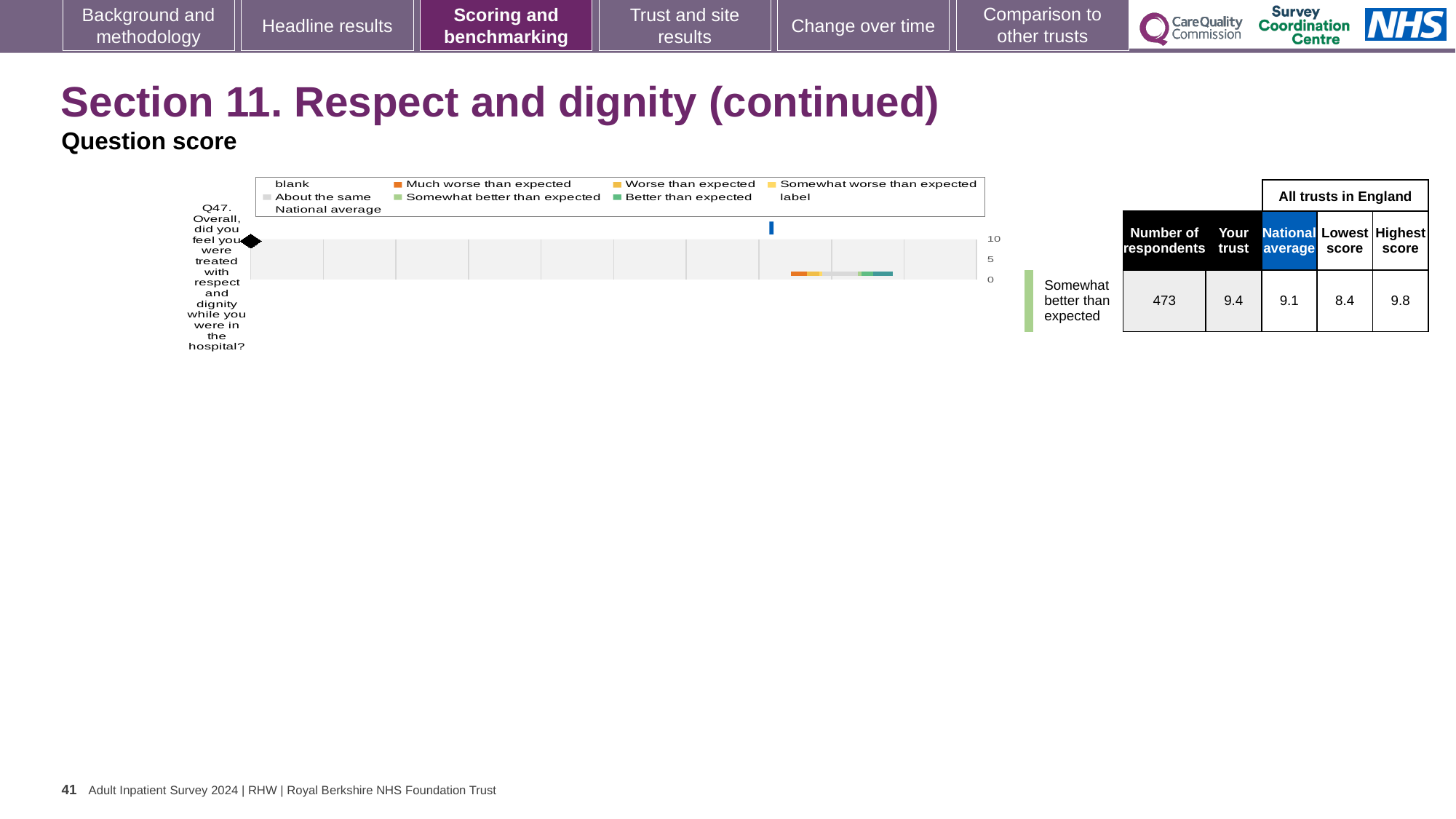
How many questions (categories) are plotted on the chart? 1 What kind of chart is shown on the slide? bar chart What is the Lowest score among all trusts in England for Q47? 8.4 What is the 'Your trust' score for Q47 shown in the table next to the chart? 9.4 What is the difference between the 'Your trust' score and the National average for Q47? 0.3 Which is larger for Q47, the 'Your trust' score or the National average? Your trust What is the highest value shown on the chart's axis? 10 What benchmark category is the trust's Q47 score given on the slide? Somewhat better than expected What is the Highest score among all trusts in England for Q47? 9.8 Which question is plotted on the chart? Q47. Overall, did you feel you were treated with respect and dignity while you were in the hospital? How many respondents answered Q47? 473 What is the National average score for Q47 shown in the table next to the chart? 9.1